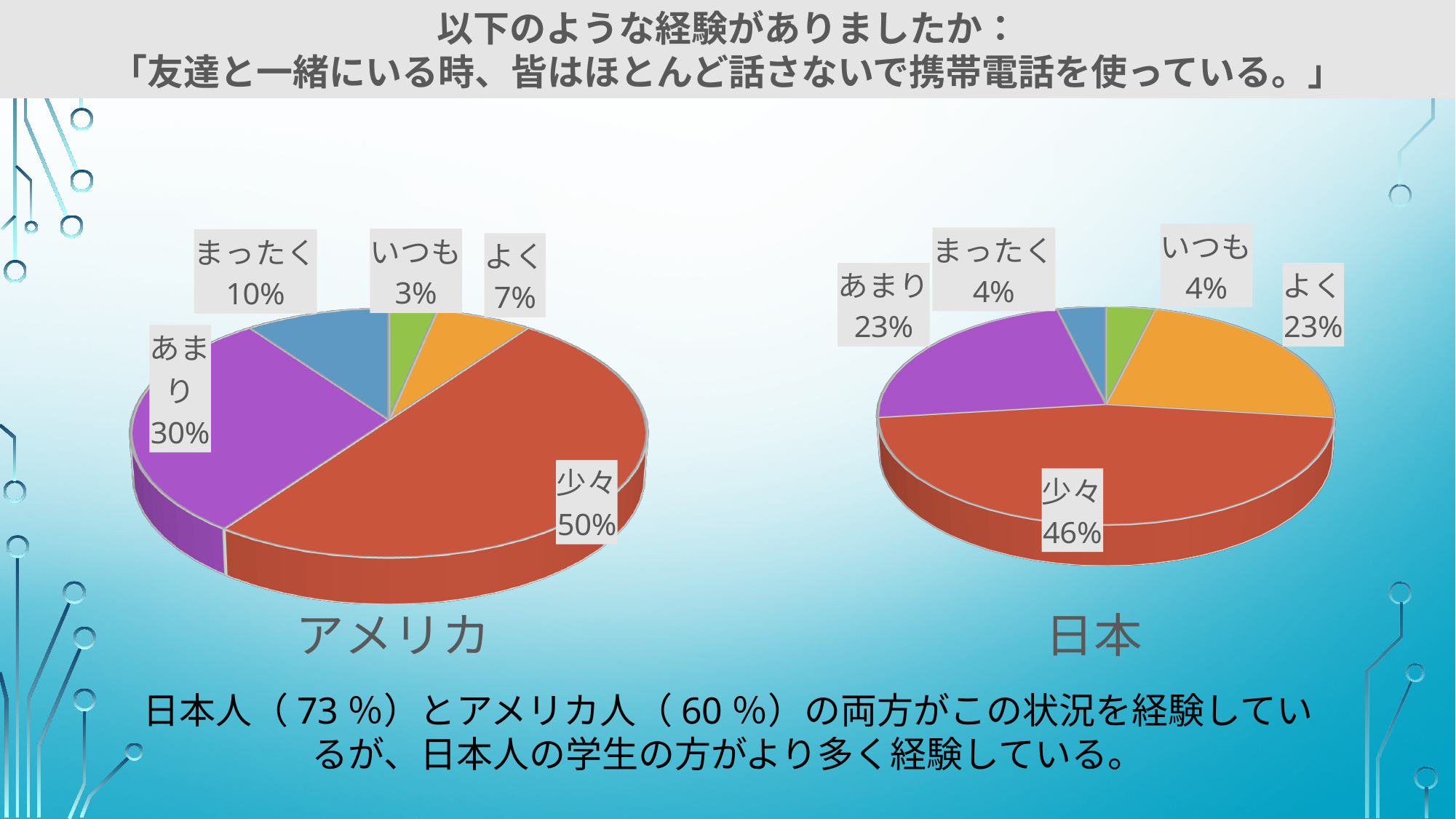
In the アメリカ pie chart, which category has the largest share? 少々 In the 日本 pie chart, which category has the largest share? 少々 In the 日本 pie chart, what is the difference between 少々 and よく? 23% In the アメリカ pie chart, what is the value for いつも? 3% In the 日本 pie chart, what is the value for あまり? 23% In the 日本 pie chart, what is the value for まったく? 4% In the アメリカ pie chart, what is the value for 少々? 50% How many categories does the アメリカ pie chart show? 5 In the アメリカ pie chart, which category has the smallest share? いつも In the アメリカ pie chart, what is the difference between 少々 and あまり? 20% What type of chart is used for the 日本 data? Pie chart Which is larger: よく in the アメリカ chart or よく in the 日本 chart? 日本